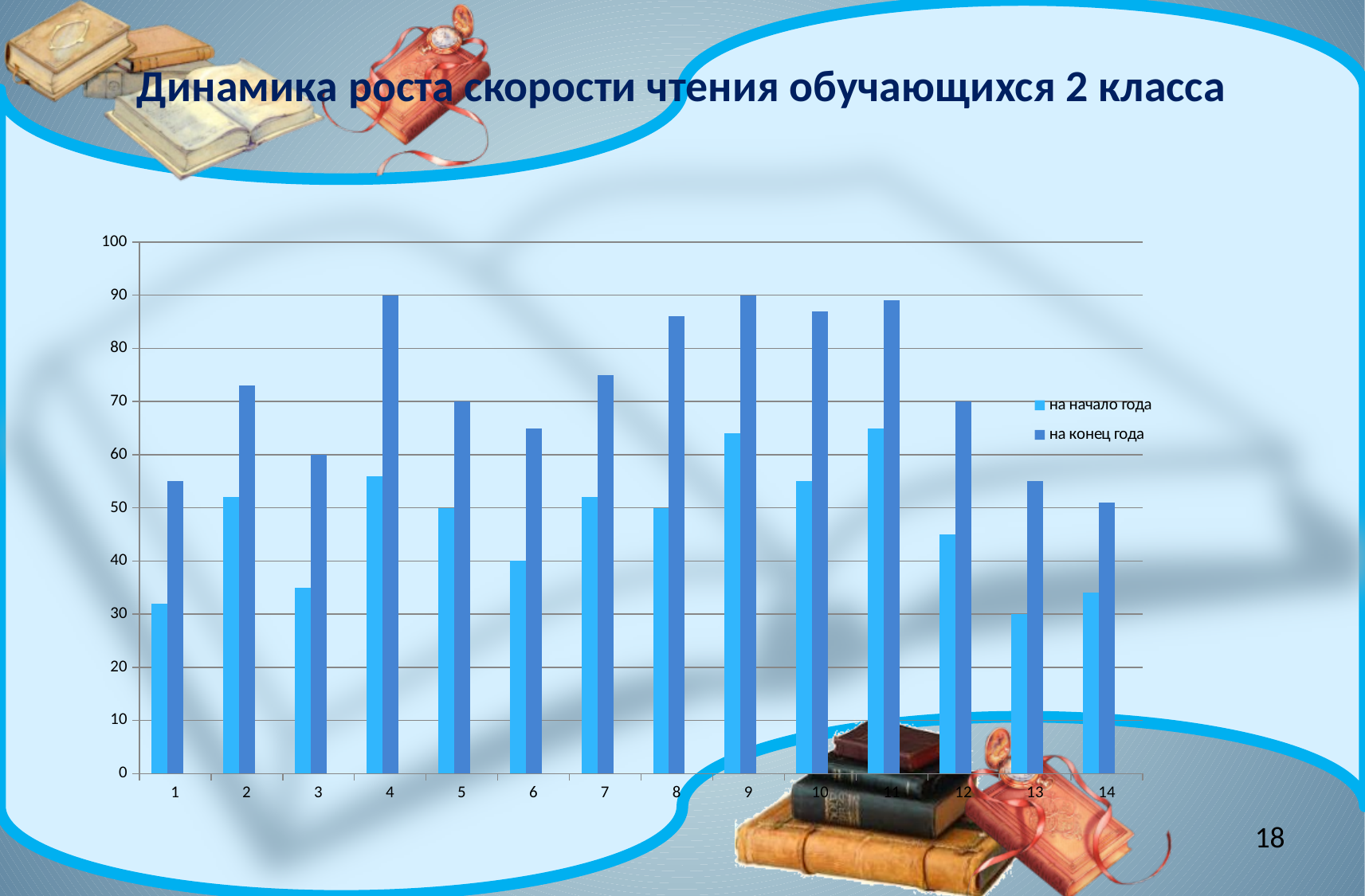
Which category has the lowest 'на начало года' value? 13 How many series does the legend list? 2 Is the value for 'на конец года' for category 3 greater or less than 70? less Is the value for 'на начало года' for category 11 greater or less than 60? greater Is the value for 'на конец года' for category 14 greater or less than 60? less What is the title of the slide above the chart? Динамика роста скорости чтения обучающихся 2 класса For category 1, which series has the larger value, 'на начало года' or 'на конец года'? на конец года What are the two legend entries of the chart? на начало года, на конец года How many categories are shown on the x axis? 14 What kind of chart is shown on the slide? bar chart